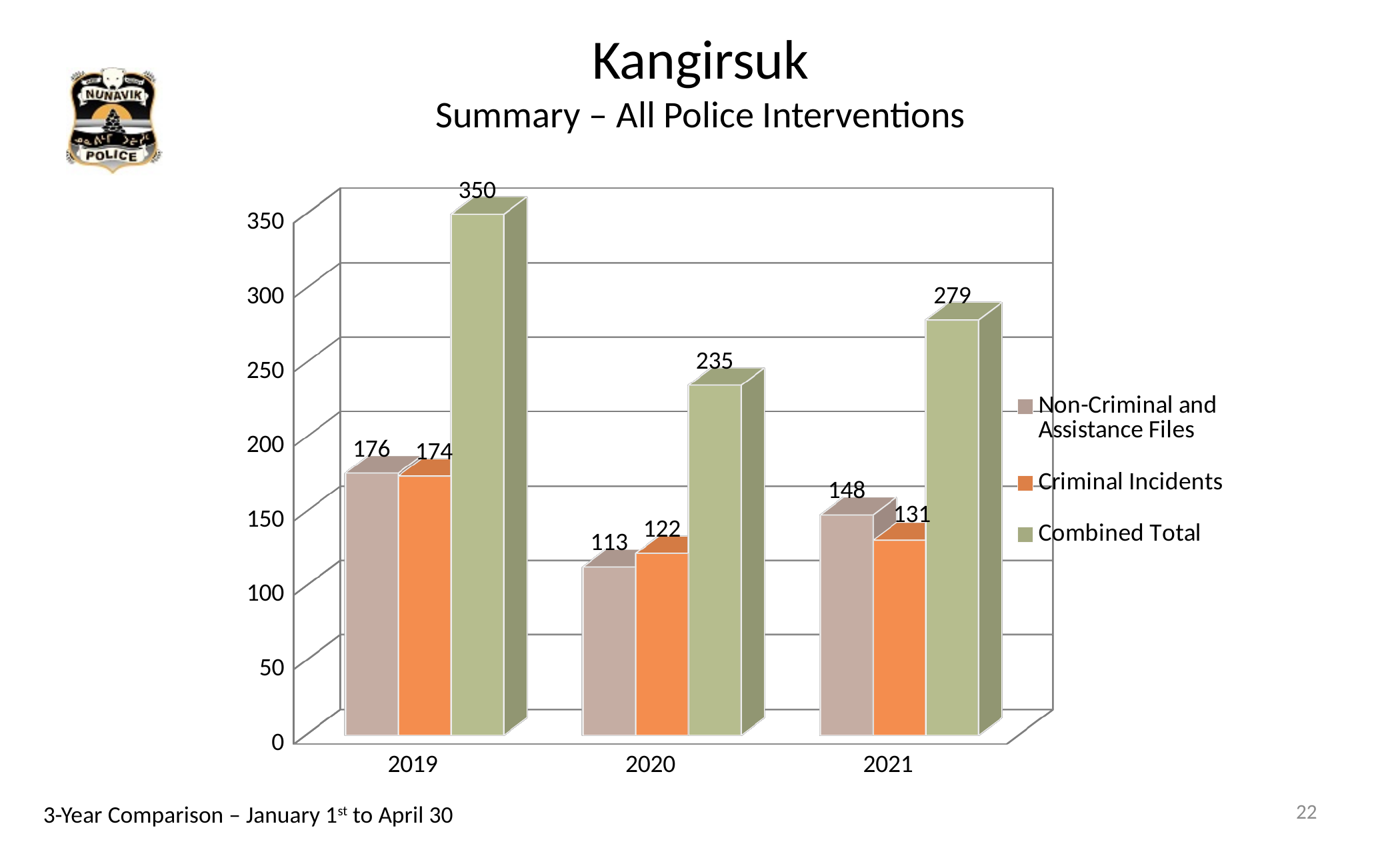
What is the value for Non-Criminal and Assistance Files in 2019? 176 Which is larger in 2021: Non-Criminal and Assistance Files or Criminal Incidents? Non-Criminal and Assistance Files What is the Combined Total for 2021? 279 What kind of chart is shown on the slide? bar chart Which year has the lowest value for Non-Criminal and Assistance Files? 2020 What is the subtitle of the chart below 'Kangirsuk'? Summary – All Police Interventions How many series does the legend list? 3 Which year has the highest Combined Total? 2019 Is the Combined Total for 2020 greater or less than 250? less What is the difference between the Combined Total in 2019 and in 2020? 115 How many years are shown on the x axis? 3 What is the value for Criminal Incidents in 2020? 122